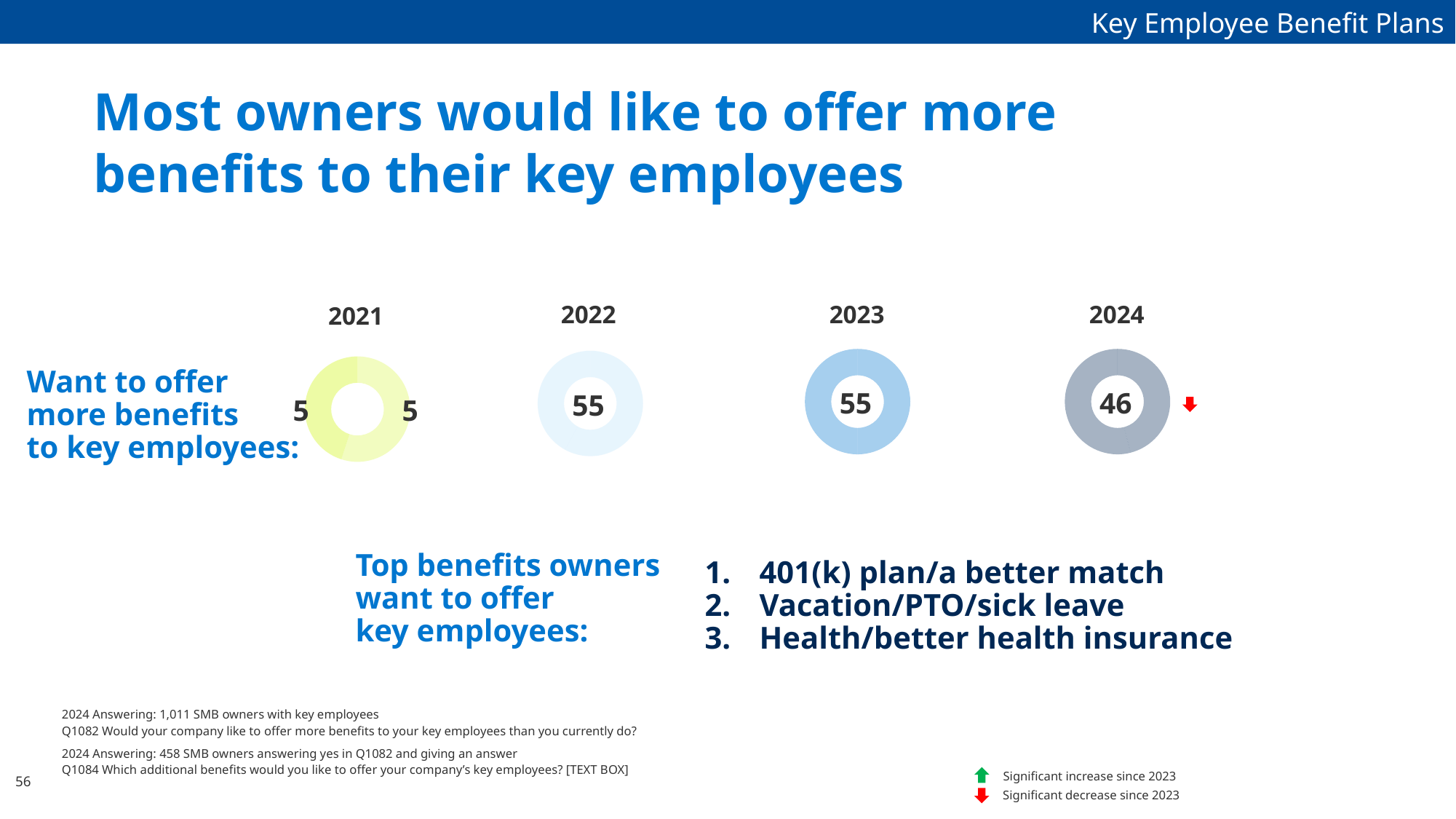
What is the value shown in the 2024 donut chart for owners who want to offer more benefits to key employees? 46 How many years (donut charts) are shown in the row of charts? 4 By how much did the value for wanting to offer more benefits to key employees change from 2023 to 2024? 9 Did the value rise or fall from 2023 to 2024? Fall Which year shows the lowest value for wanting to offer more benefits to key employees? 2024 What does the red arrow next to the 2024 donut chart indicate? Significant decrease since 2023 What is the title of the slide containing the donut charts? Most owners would like to offer more benefits to their key employees Which year shows a larger value, 2023 or 2024? 2023 What kind of chart is used to show the yearly values? Donut (pie) chart What is the value shown in the 2022 donut chart? 55 What is the value shown in the 2023 donut chart? 55 Is the 2024 value greater or less than 50? less